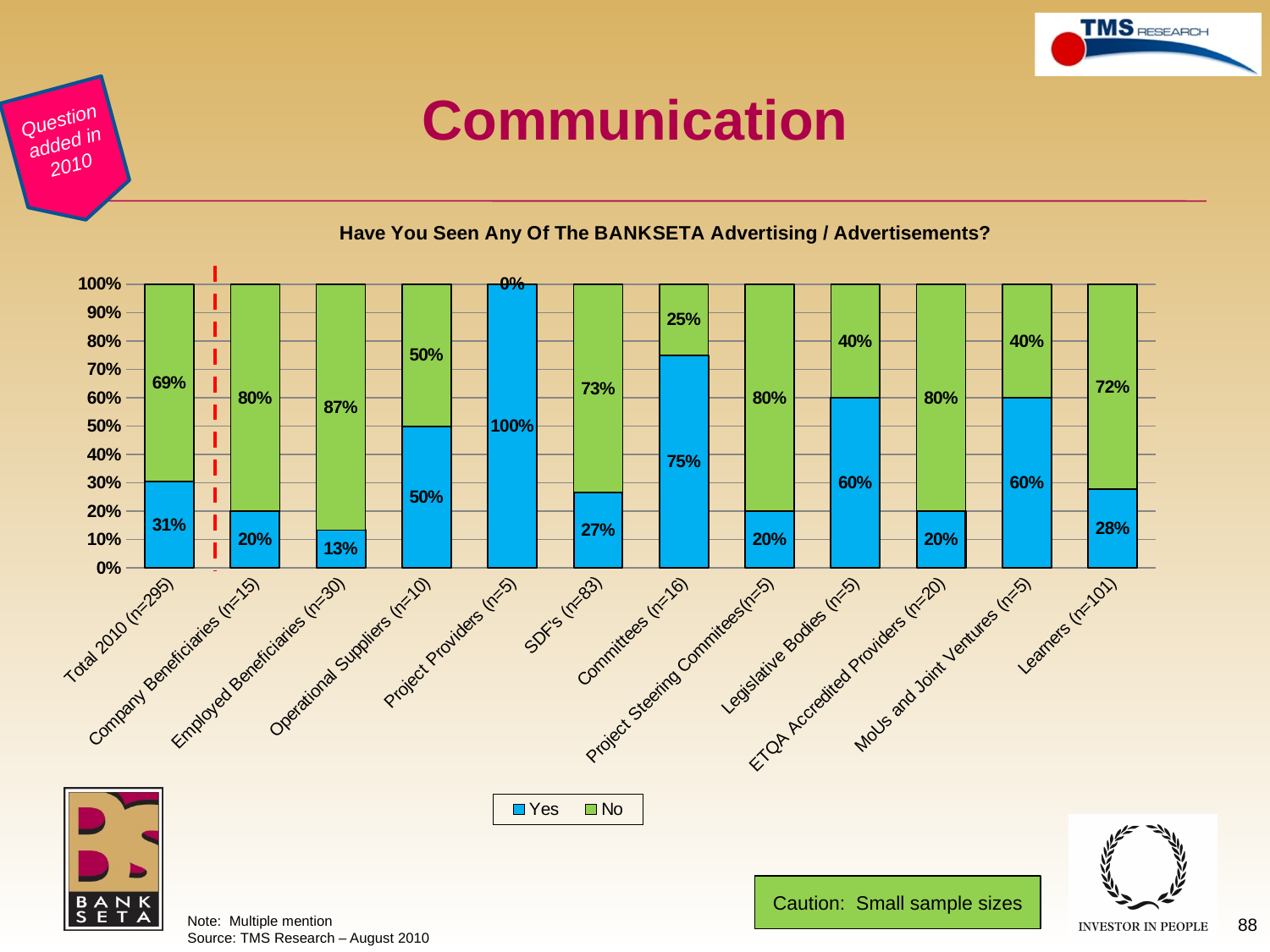
How many categories are shown on the x axis of the chart? 12 What is the difference between the No percentage for SDF's (n=83) and the No percentage for Committees (n=16)? 48% What is the title of the chart? Have You Seen Any Of The BANKSETA Advertising / Advertisements? Which category has the highest Yes percentage? Project Providers (n=5) What type of chart is shown on the slide? Stacked bar chart What percentage of Learners (n=101) answered Yes to having seen BANKSETA advertising? 28% How many series does the legend list? 2 What is the No percentage for Employed Beneficiaries (n=30)? 87% Which category has the lowest Yes percentage? Employed Beneficiaries (n=30) What is the total of the stacked bar for Operational Suppliers (n=10)? 100% What is the Yes percentage for Total 2010 (n=295)? 31% Which has a larger Yes percentage, Legislative Bodies (n=5) or Learners (n=101)? Legislative Bodies (n=5)